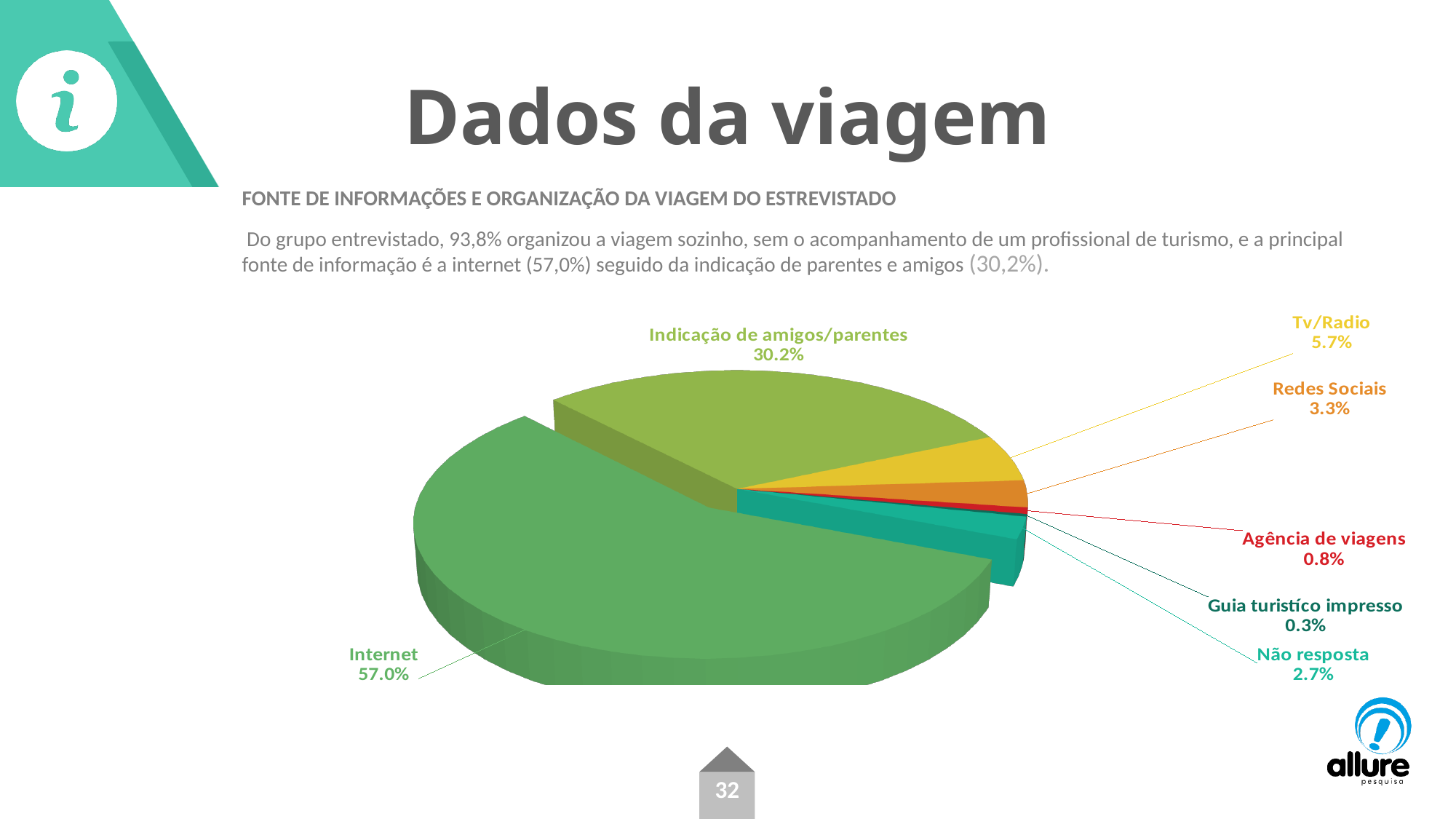
What percentage is shown for Tv/Radio? 5.7% What colour is the Internet slice of the pie? Green What is the combined share of Tv/Radio and Redes Sociais? 9.0% Which category has the smallest slice of the pie? Guia turistíco impresso Which is larger, Redes Sociais or Não resposta? Redes Sociais How many categories are shown in the pie chart? 7 What is the value for Agência de viagens? 0.8% What is the value shown for Indicação de amigos/parentes? 30.2% Which category has the largest slice of the pie? Internet What is the difference between the Internet share and the Indicação de amigos/parentes share? 26.8% What share of the pie does Internet account for? 57.0% What kind of chart is shown on the slide? Pie chart